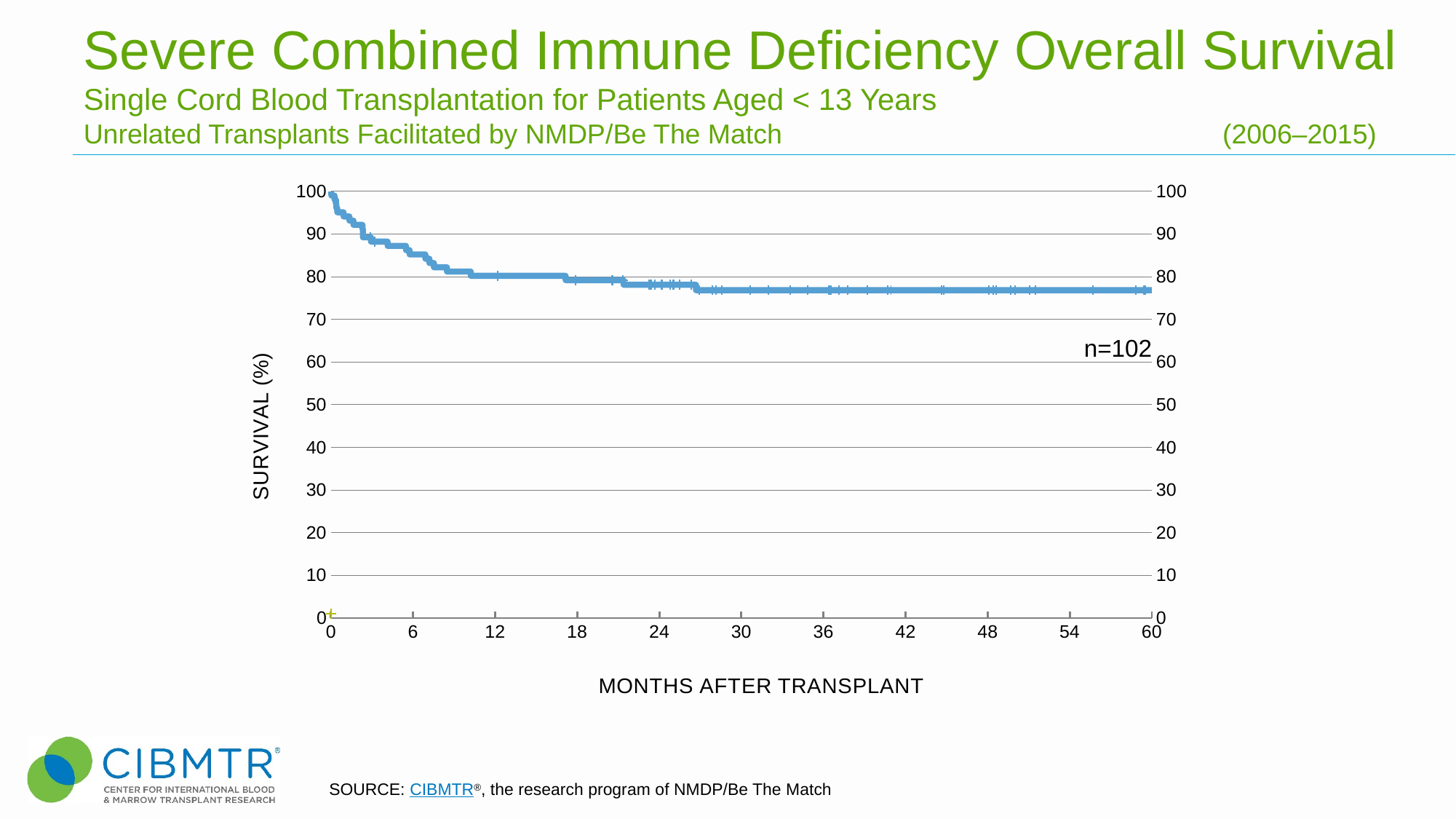
What kind of chart is shown on the slide? line chart What is the survival percentage at 0 months after transplant? 100 Is the survival value at 60 months after transplant greater or less than 80? less Is the survival value at 36 months after transplant greater or less than 90? less Does the survival curve rise or fall as months after transplant increase? fall What is the number of patients (n) shown on the chart? n=102 Is the survival value at 12 months after transplant greater or less than 70? greater How many survival curves are plotted on the chart? 1 What is the label of the x axis? MONTHS AFTER TRANSPLANT